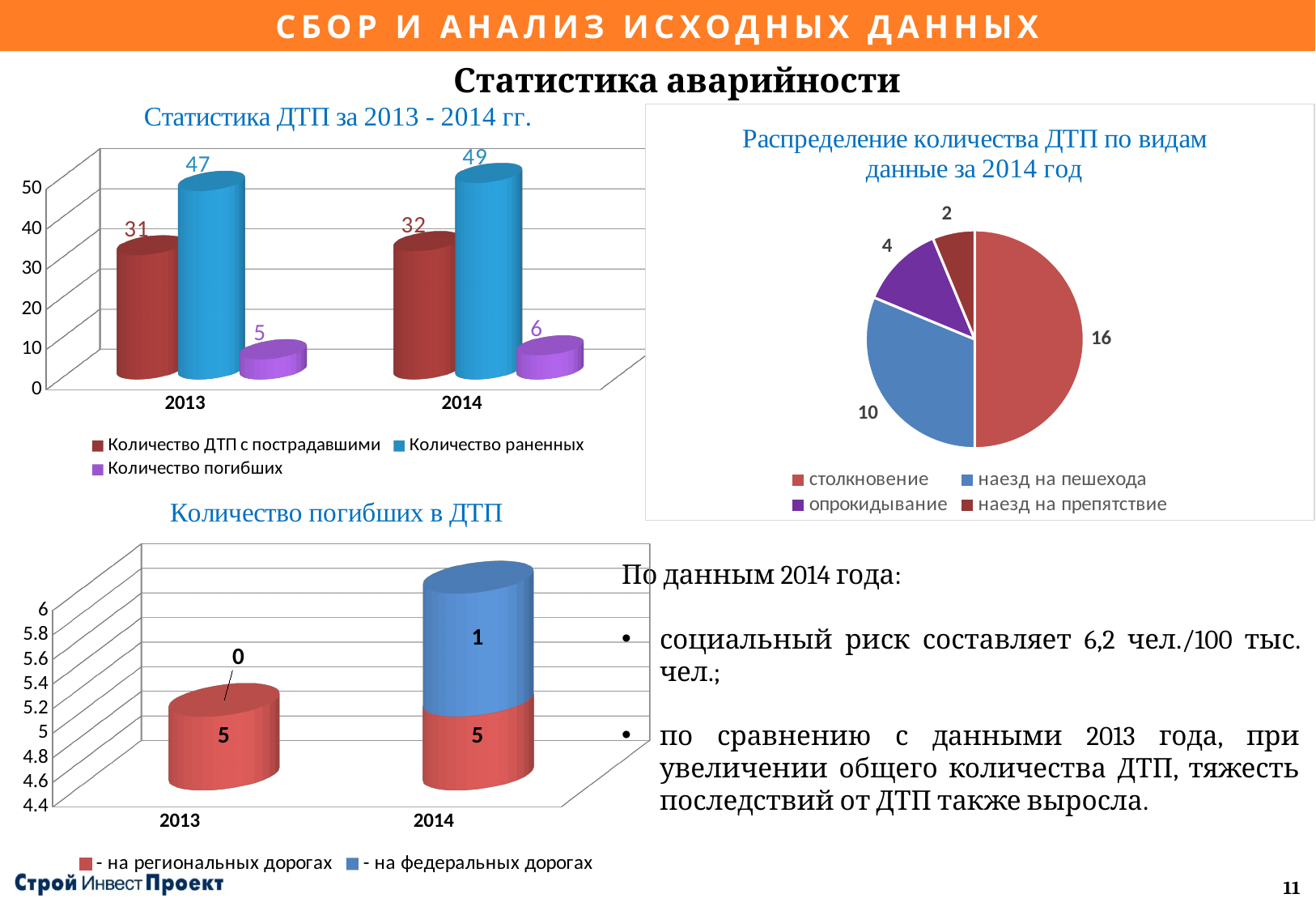
In the chart 'Статистика ДТП за 2013 - 2014 гг.', by how much did 'Количество раненных' change from 2013 to 2014? 2 In the pie chart 'Распределение количества ДТП по видам', which category has the smallest value? наезд на препятствие In the pie chart 'Распределение количества ДТП по видам', what is the value for 'наезд на пешехода'? 10 In the chart 'Статистика ДТП за 2013 - 2014 гг.', does 'Количество погибших' rise or fall from 2013 to 2014? rise In the pie chart 'Распределение количества ДТП по видам', what share of the total does 'столкновение' represent? 50% In the pie chart 'Распределение количества ДТП по видам', how many categories are shown? 4 In the chart 'Статистика ДТП за 2013 - 2014 гг.', what is the value of 'Количество ДТП с пострадавшими' for 2013? 31 In the chart 'Количество погибших в ДТП', what is the value for 'на федеральных дорогах' in 2014? 1 In the chart 'Количество погибших в ДТП', what is the total of the stacked bar for 2014? 6 In the chart 'Статистика ДТП за 2013 - 2014 гг.', how many series does the legend list? 3 What type of chart is 'Количество погибших в ДТП'? stacked bar chart In the chart 'Статистика ДТП за 2013 - 2014 гг.', what is the value of 'Количество раненных' for 2014? 49